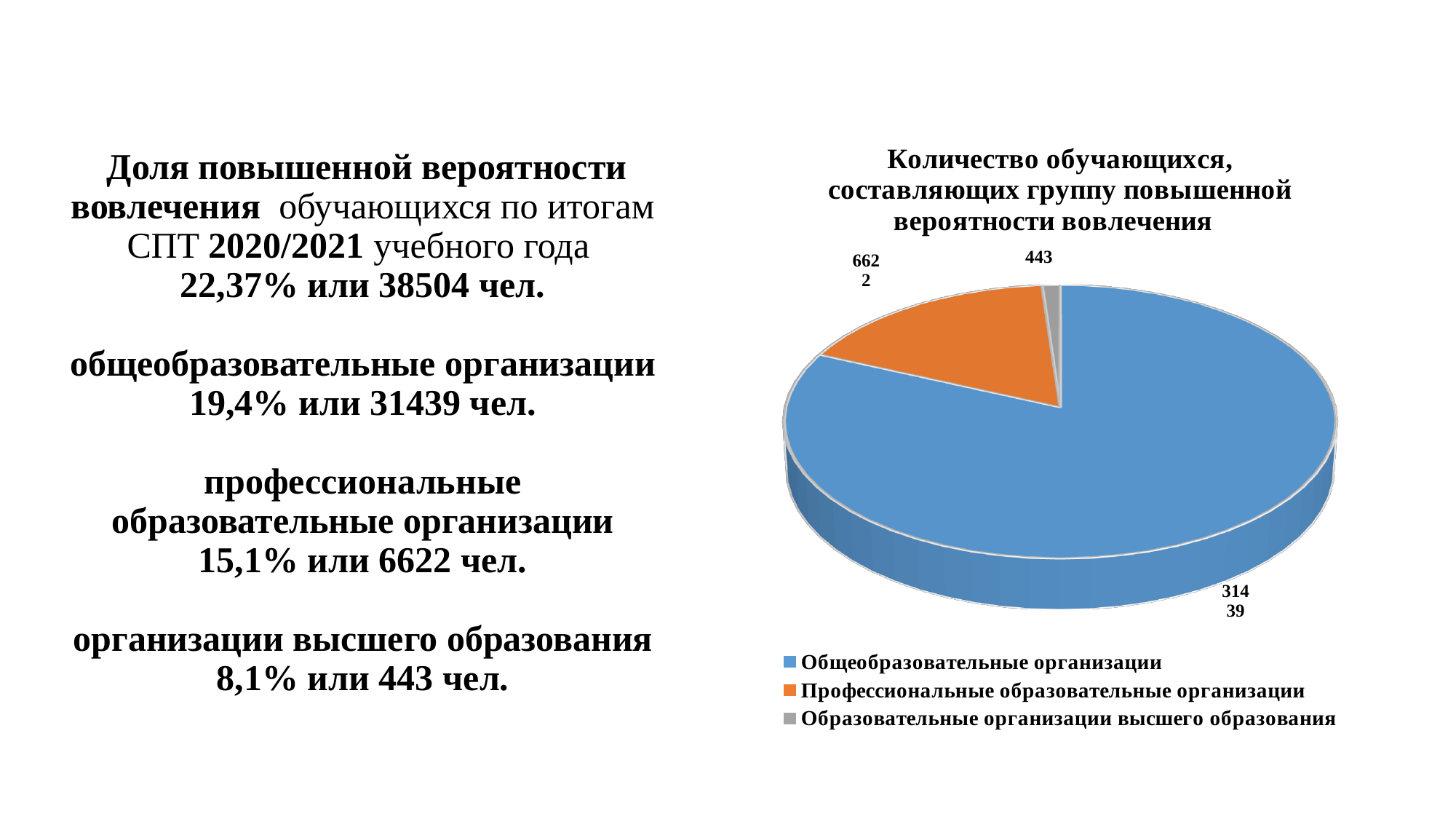
Which category has the largest slice in the pie chart? Общеобразовательные организации Which category has the smallest slice in the pie chart? Образовательные организации высшего образования How many categories does the pie chart show? 3 What is the difference between the values for Общеобразовательные организации and Профессиональные образовательные организации? 24817 What is the title of the pie chart? Количество обучающихся, составляющих группу повышенной вероятности вовлечения What is the total of all slices in the pie chart? 38504 What is the value for Общеобразовательные организации in the pie chart? 31439 What is the value for Образовательные организации высшего образования in the pie chart? 443 What type of chart is shown on the slide? pie chart What is the value for Профессиональные образовательные организации in the pie chart? 6622 Which is larger: the value for Профессиональные образовательные организации or for Образовательные организации высшего образования? Профессиональные образовательные организации What is the difference between the values for Профессиональные образовательные организации and Образовательные организации высшего образования? 6179